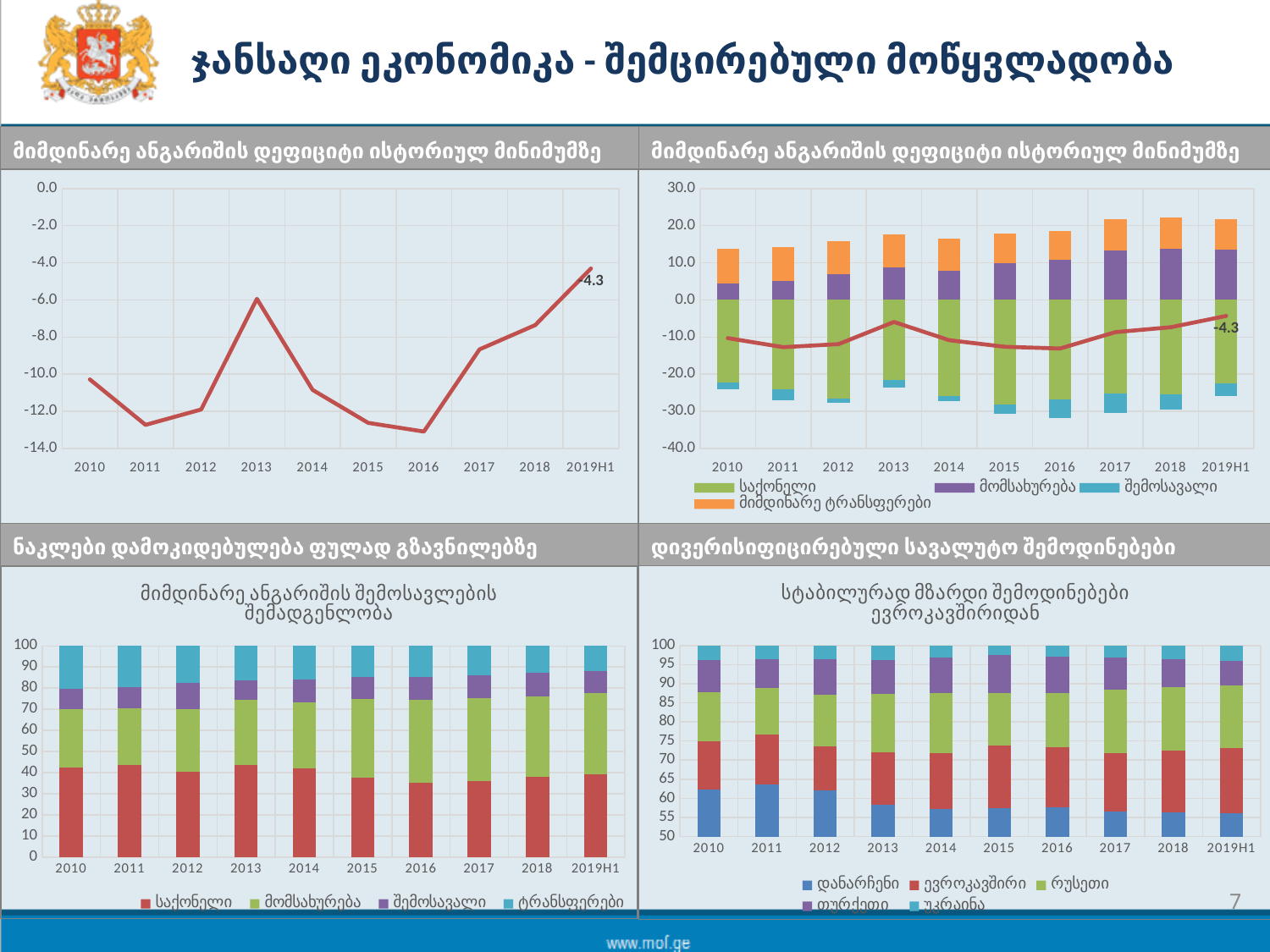
On the top-left line chart, which year has the highest (least negative) value? 2019H1 How many series does the legend of the top-right stacked bar chart list? 4 How many series does the legend of the bottom-right chart (სტაბილურად მზარდი შემოდინებები ევროკავშირიდან) list? 5 On the bottom-right chart, is the value of the დანარჩენი segment for 2011 greater or less than 60? greater On the top-left line chart, which is larger, the value for 2013 or the value for 2014? 2013 How many points are plotted along the x axis of the top-left line chart? 10 What kind of chart is the top-left chart on the slide? line chart On the top-left line chart, is the value for 2013 greater or less than -8.0? greater On the top-left line chart, what value is labelled for 2019H1? -4.3 On the top-left line chart, does the line rise or fall from 2016 to 2019H1? rise How many series does the legend of the bottom-left chart (მიმდინარე ანგარიშის შემოსავლების შემადგენლობა) list? 4 On the top-right chart, what value is labelled on the line at 2019H1? -4.3